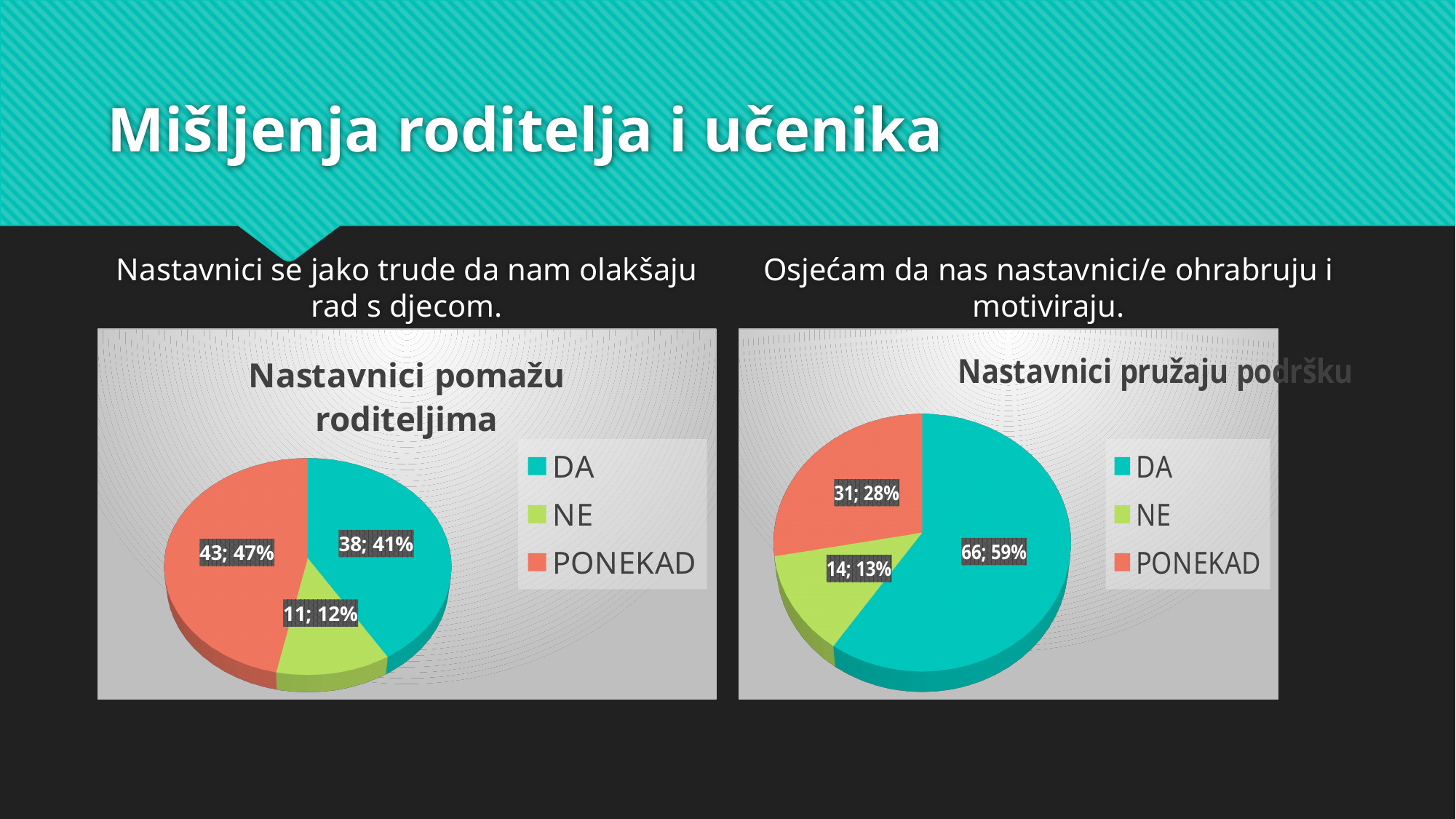
In the chart titled "Nastavnici pružaju podršku", which category has the smallest slice? NE In the chart titled "Nastavnici pružaju podršku", what is the difference in count between DA and PONEKAD? 35 In the chart titled "Nastavnici pružaju podršku", what is the value for PONEKAD? 31; 28% In the chart titled "Nastavnici pomažu roditeljima", what is the value for NE? 11; 12% In the chart titled "Nastavnici pomažu roditeljima", which category has the smallest slice? NE What kind of chart is the chart titled "Nastavnici pomažu roditeljima"? Pie chart How many categories does the legend of the chart titled "Nastavnici pružaju podršku" list? 3 In the chart titled "Nastavnici pomažu roditeljima", which category has the largest slice? PONEKAD In the chart titled "Nastavnici pružaju podršku", which is larger, DA or PONEKAD? DA In the chart titled "Nastavnici pružaju podršku", what is the value for DA? 66; 59% In the chart titled "Nastavnici pomažu roditeljima", what is the value for DA? 38; 41% In the chart titled "Nastavnici pomažu roditeljima", what share of the pie does PONEKAD take? 47%